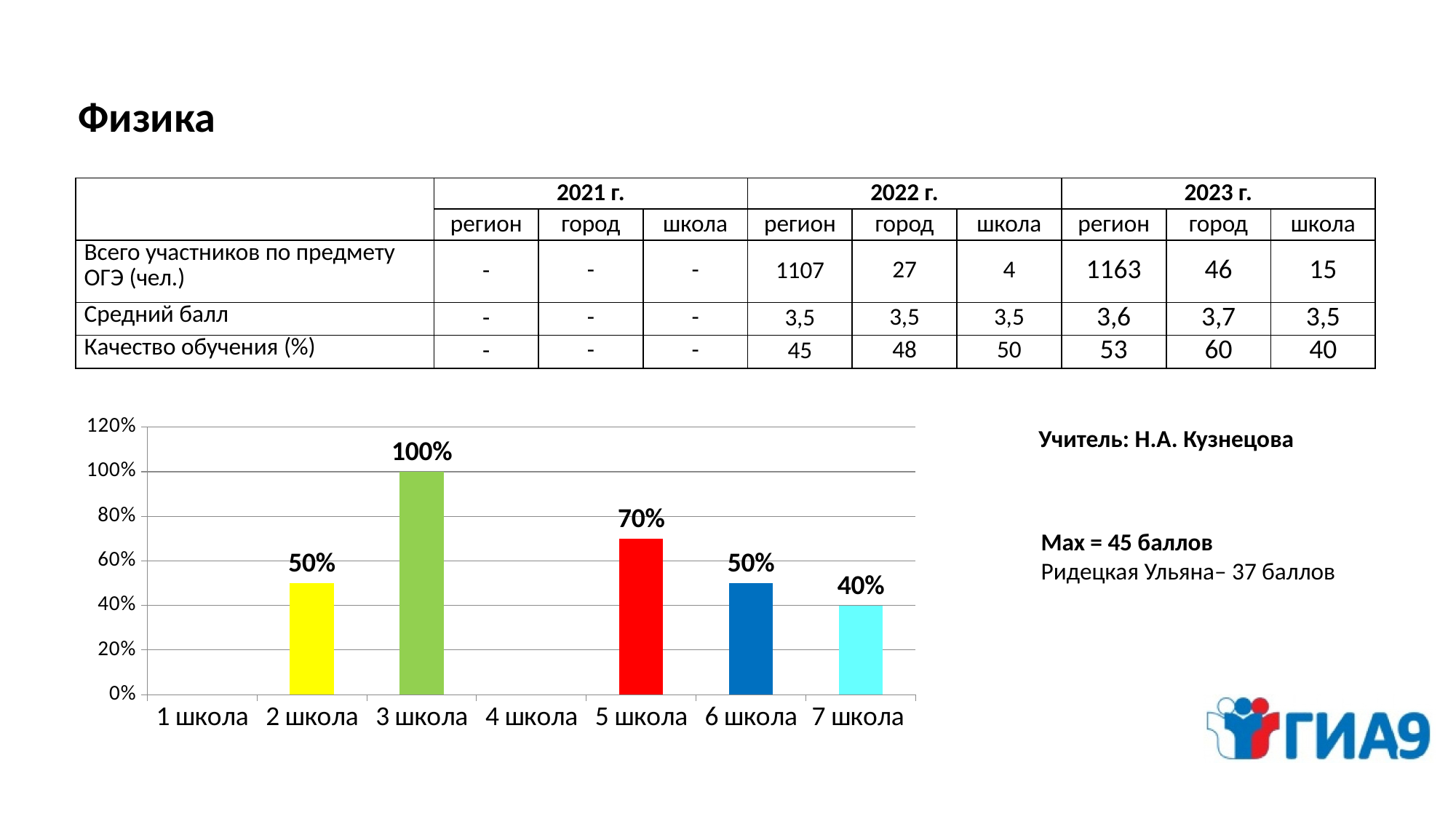
How many school categories are shown on the x axis of the bar chart? 7 What is the value for 3 школа in the bar chart? 100% Among the schools with a visible bar, which has the lowest value? 7 школа What is the difference between the values for 6 школа and 7 школа? 10% What kind of chart is shown on the slide? bar chart What is the value for 2 школа in the bar chart? 50% What is the value for 7 школа in the bar chart? 40% Which is larger, the value for 5 школа or the value for 6 школа? 5 школа What is the difference between the values for 3 школа and 5 школа? 30% Is the value for 5 школа greater or less than 60%? greater What is the value for 5 школа in the bar chart? 70% Which school has the highest value in the bar chart? 3 школа